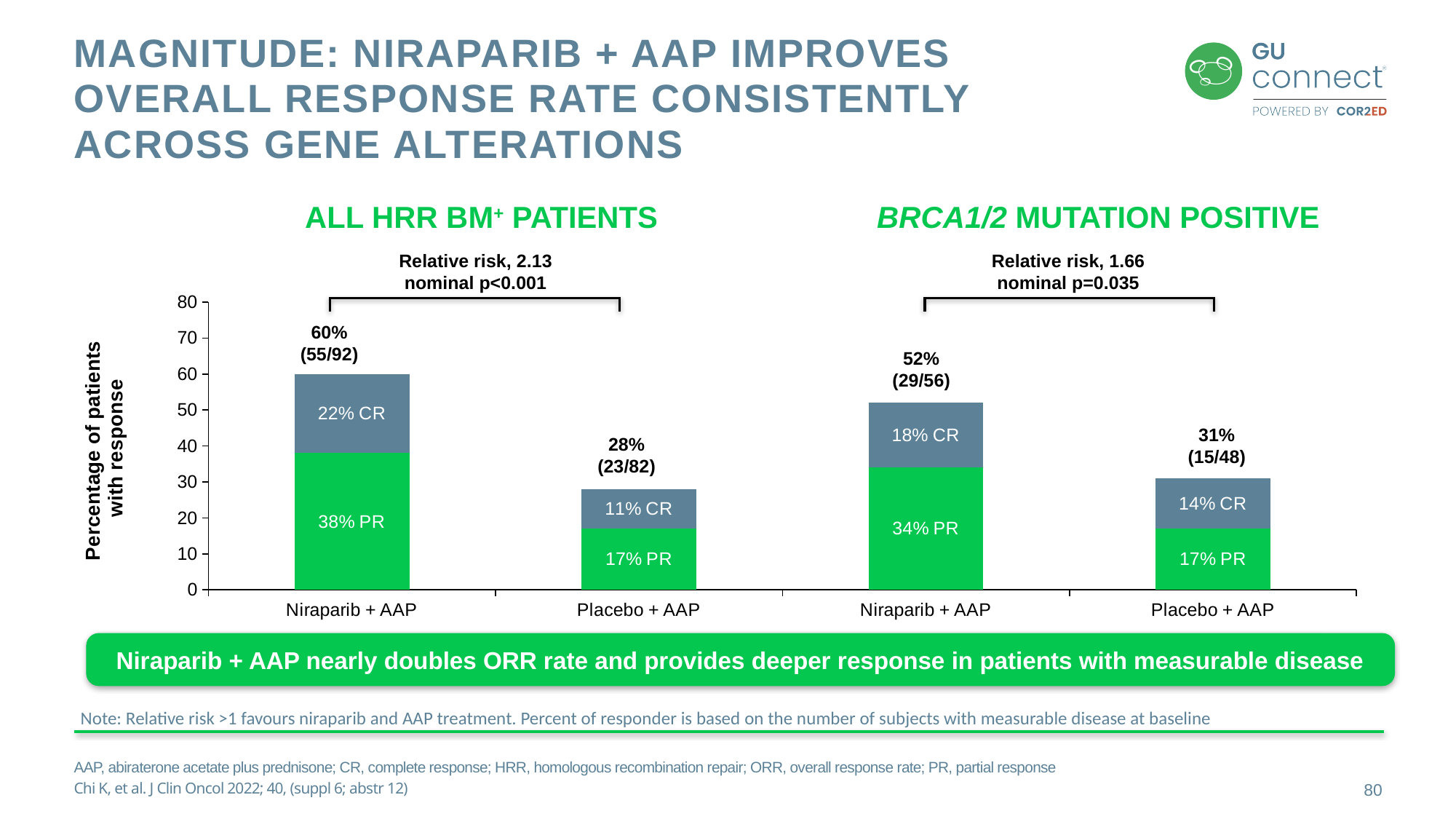
What is the relative risk shown for the All HRR BM+ patients comparison? 2.13 In the BRCA1/2 mutation positive group, which has a higher CR percentage, Niraparib + AAP or Placebo + AAP? Niraparib + AAP How many bars are plotted on the chart? 4 Which bar has the highest total response rate on the chart? Niraparib + AAP (All HRR BM+ patients) Which bar has the lowest total response rate on the chart? Placebo + AAP (All HRR BM+ patients) What kind of chart is shown on the slide? Stacked bar chart What is the nominal p-value shown for the BRCA1/2 mutation positive comparison? p=0.035 What is the CR percentage for Niraparib + AAP in the BRCA1/2 mutation positive group? 18% CR What is the number of responders out of total shown for Placebo + AAP in the BRCA1/2 mutation positive group? 15/48 What is the total overall response rate for Niraparib + AAP in the All HRR BM+ patients group? 60% What is the difference in total response rate between Niraparib + AAP and Placebo + AAP in the All HRR BM+ patients group? 32% What is the PR percentage for Placebo + AAP in the BRCA1/2 mutation positive group? 17% PR